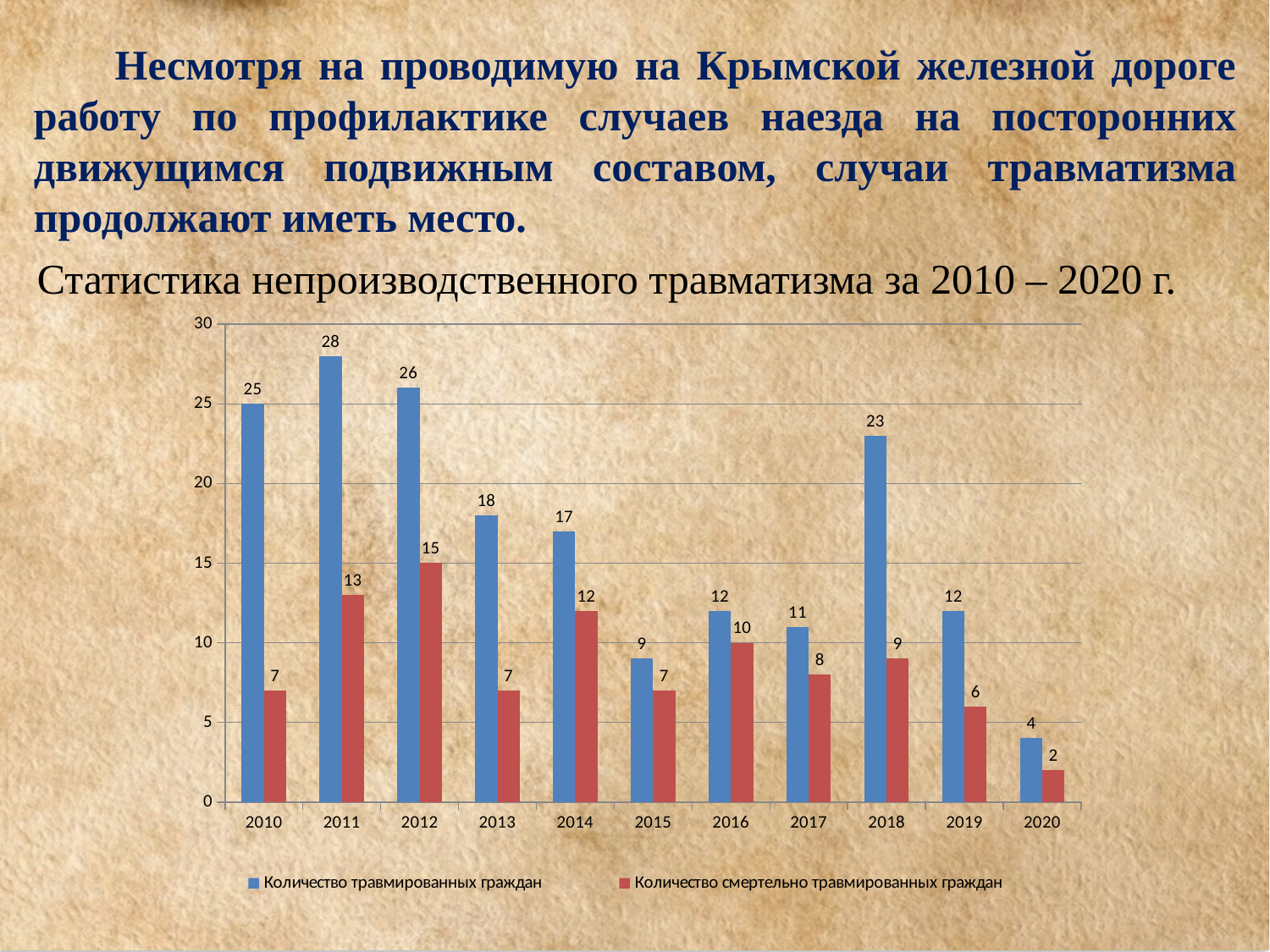
In which year was the number of injured citizens highest? 2011 Which year had more injured citizens, 2013 or 2019? 2013 How many years are shown on the x axis of the chart? 11 In which year was the number of fatally injured citizens lowest? 2020 What type of chart is shown on the slide? bar chart What was the number of injured citizens (Количество травмированных граждан) in 2012? 26 What colour are the bars for the series 'Количество смертельно травмированных граждан'? red What is the difference between the number of injured citizens and the number of fatally injured citizens in 2018? 14 Is the number of injured citizens in 2010 greater or less than 20? greater Does the number of injured citizens rise or fall from 2018 to 2020? fall How many series does the chart legend list? 2 What was the number of fatally injured citizens (Количество смертельно травмированных граждан) in 2014? 12